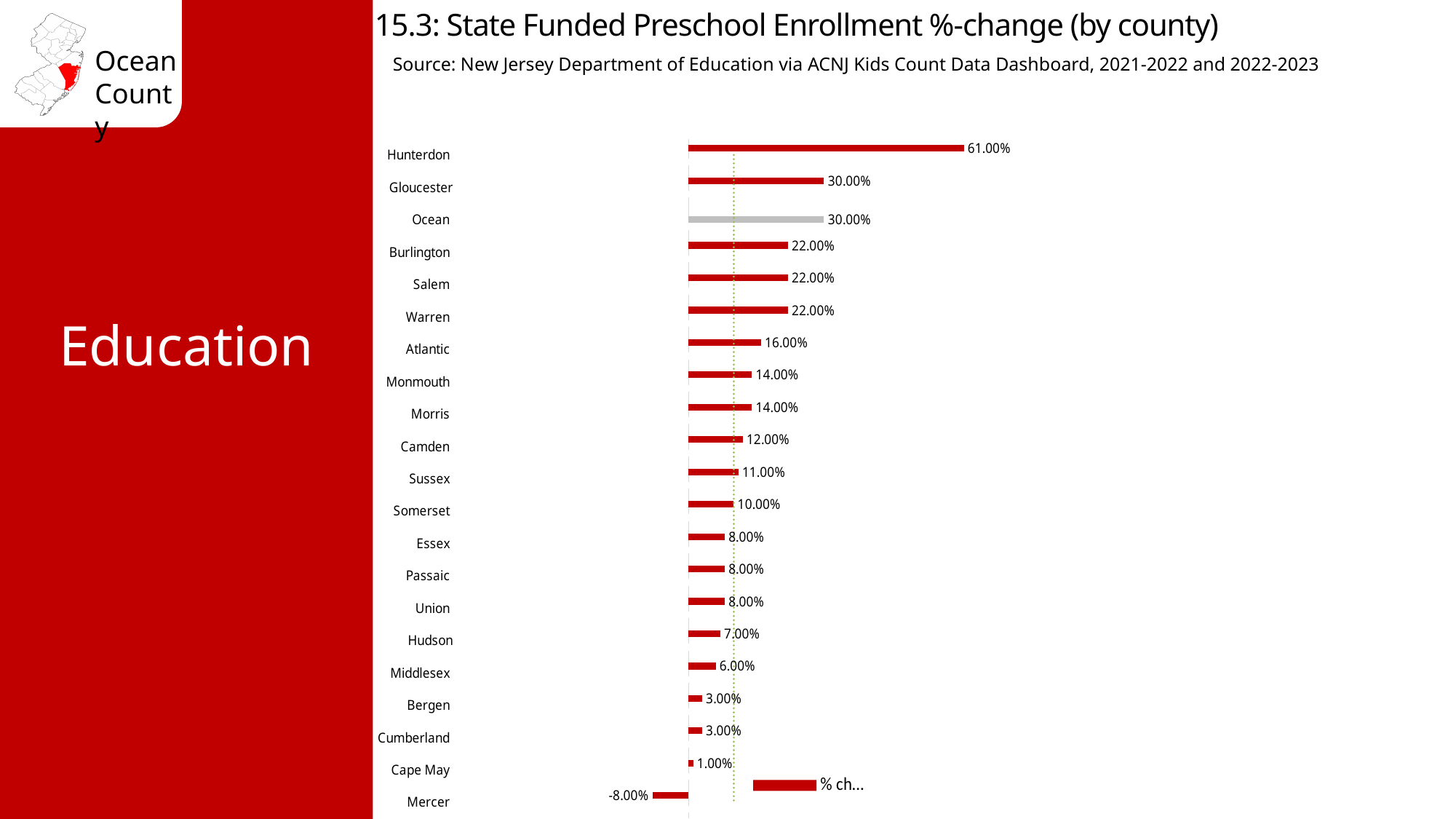
Which county's bar is drawn in grey instead of red? Ocean What kind of chart is shown on the slide? Bar chart How many counties are shown in the chart? 21 What is the %-change value shown for Ocean county? 30.00% What is the %-change value shown for Mercer? -8.00% What is the state funded preschool enrollment %-change for Hunterdon? 61.00% What is the source of the data shown in the chart? New Jersey Department of Education via ACNJ Kids Count Data Dashboard, 2021-2022 and 2022-2023 Which county has the highest %-change? Hunterdon What is the %-change value shown for Atlantic? 16.00% What is the difference between the %-change for Hunterdon and Gloucester? 31.00% Which has a larger %-change, Burlington or Camden? Burlington Which county has the lowest %-change? Mercer